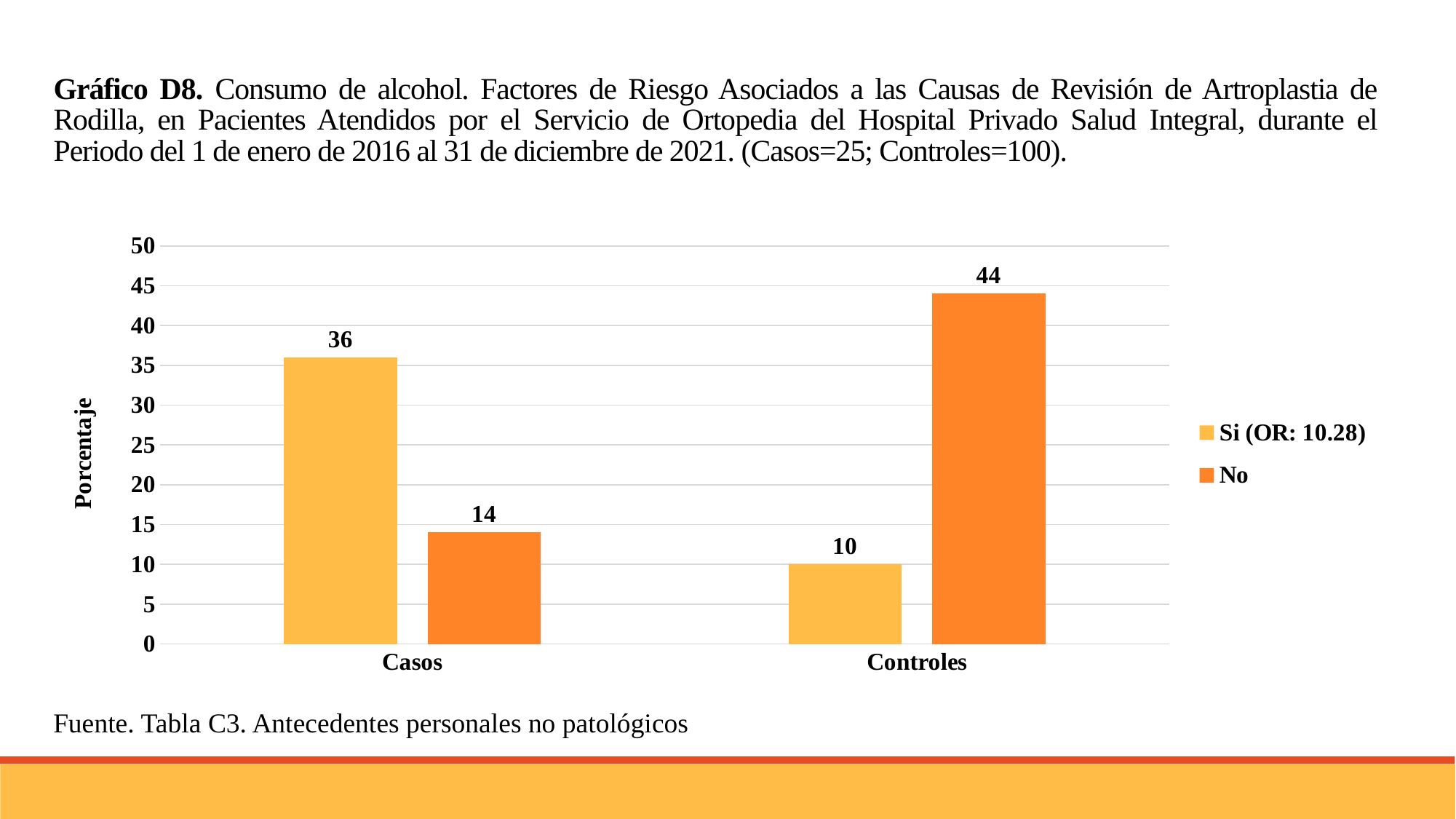
What is the difference between the 'No' value for Controles and the 'No' value for Casos? 30 What is the value of the 'Si (OR: 10.28)' series for Casos? 36 What is the value of the 'No' series for Controles? 44 What is the value of the 'Si (OR: 10.28)' series for Controles? 10 Which is larger for Casos: the 'Si (OR: 10.28)' value or the 'No' value? Si (OR: 10.28) What is the value of the 'No' series for Casos? 14 How many categories are shown on the x axis? 2 Which category has the lowest value for the 'Si (OR: 10.28)' series? Controles What is the label of the y axis? Porcentaje Which category has the highest value for the 'No' series? Controles How many series does the legend list? 2 What kind of chart is shown on the slide? Bar chart